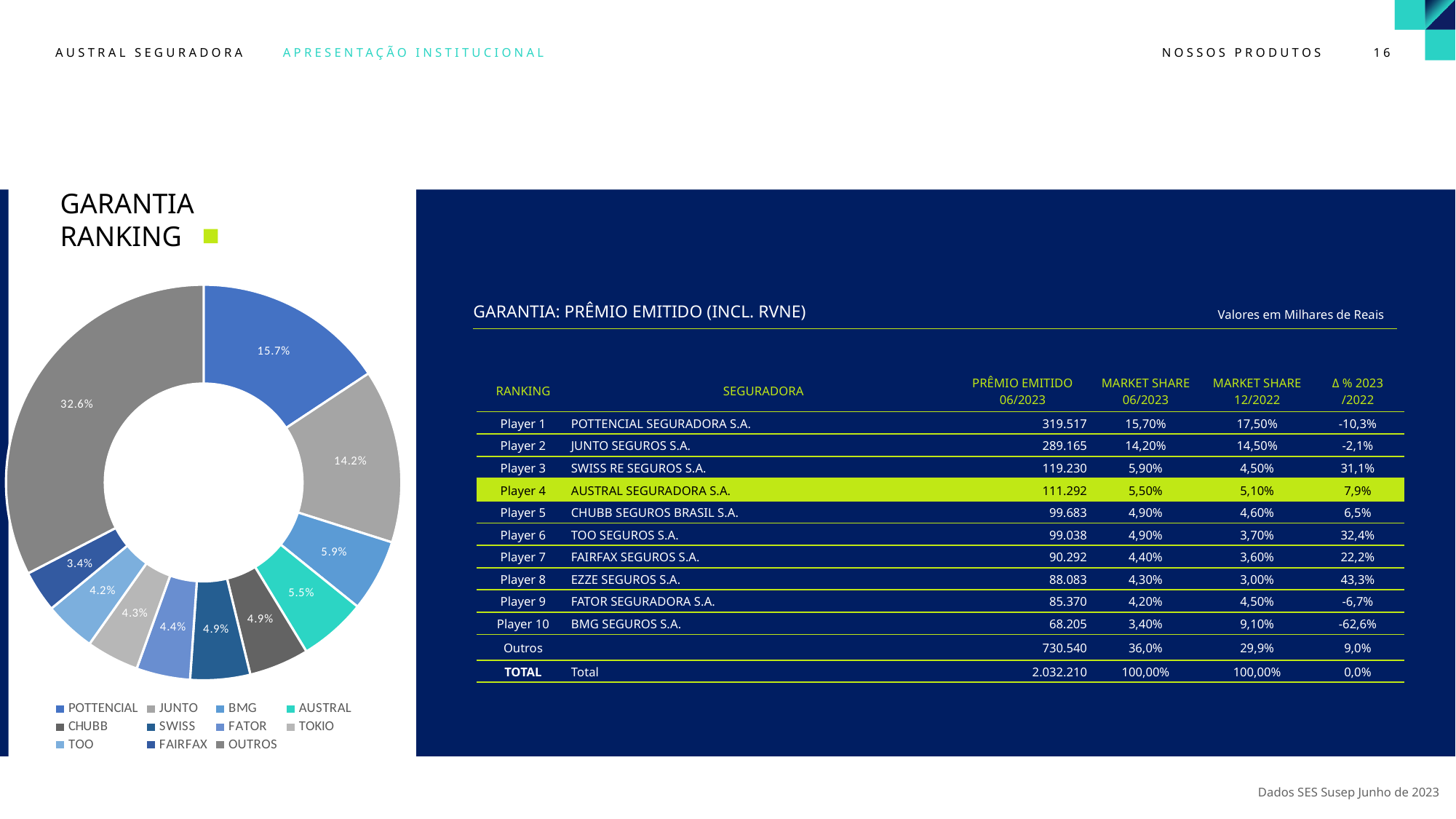
In the pie chart, which is larger: the AUSTRAL slice or the JUNTO slice? JUNTO What is the title of the chart on the left of the slide? GARANTIA RANKING How many slices does the pie chart have? 11 In the pie chart, what is the difference between the OUTROS and POTTENCIAL shares? 16.9 percentage points What kind of chart is shown on the left of the slide? doughnut chart What share of the pie chart does AUSTRAL hold? 5.5% Which category has the largest slice in the pie chart? OUTROS How many entries does the pie chart's legend list? 11 In the pie chart, what is the difference between the POTTENCIAL and JUNTO shares? 1.5 percentage points What is the smallest percentage shown on any slice of the pie chart? 3.4% What value is shown for POTTENCIAL in the pie chart? 15.7% What value is shown for JUNTO in the pie chart? 14.2%